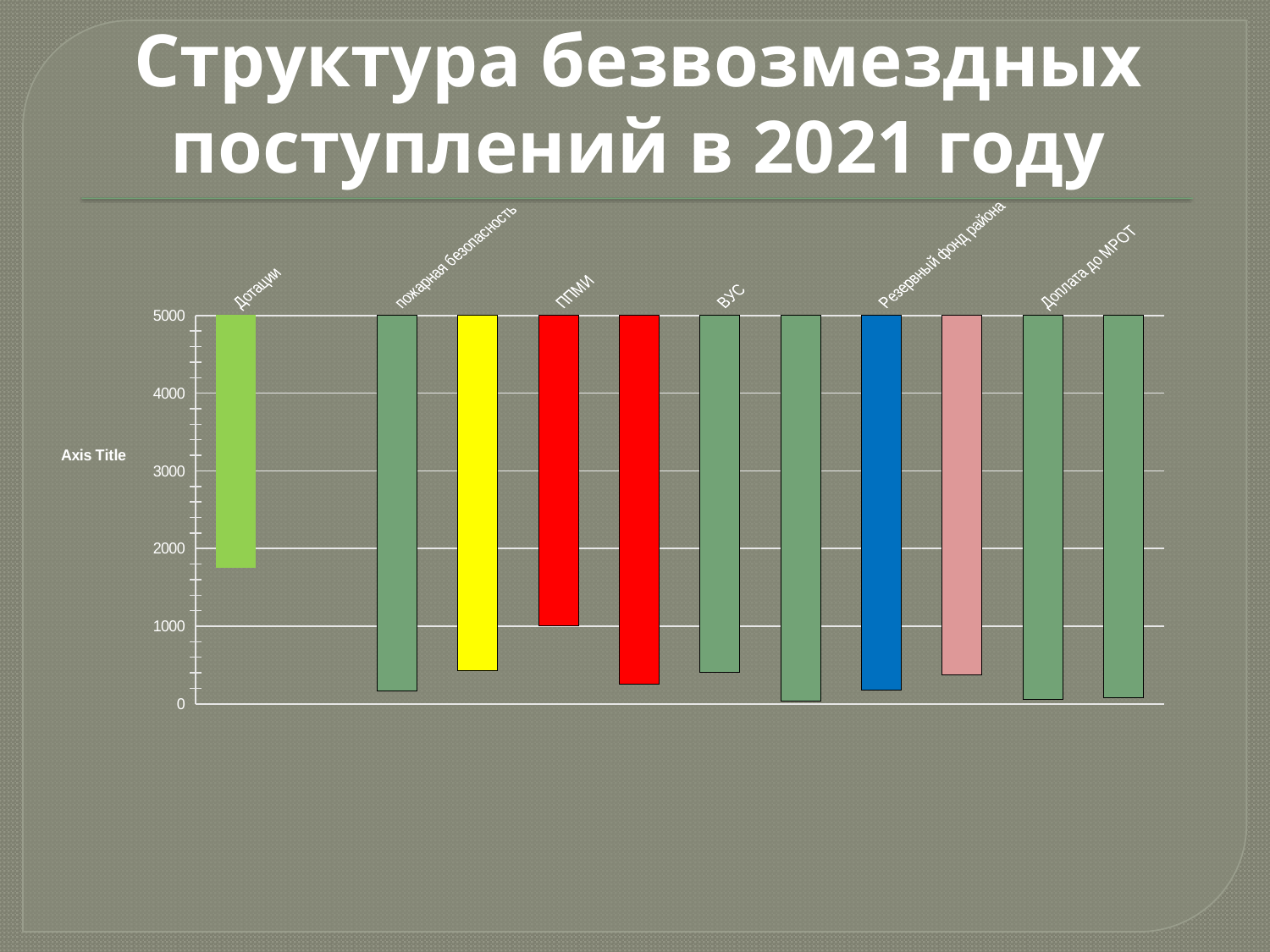
How many bars are plotted in the chart? 11 What is the title of the slide above the chart? Структура безвозмездных поступлений в 2021 году Which bar extends lowest on the axis: the light green first bar or the blue bar? the blue bar Is the lower end of the light green bar (first bar, under the label Дотации) greater or less than 1000? greater Is the lower end of the yellow bar greater or less than 1000? less How many category labels are written above the chart? 6 What is the highest value shown on the vertical axis? 5000 What kind of chart is shown on the slide? bar chart Is the lower end of the pink bar greater or less than 1000? less